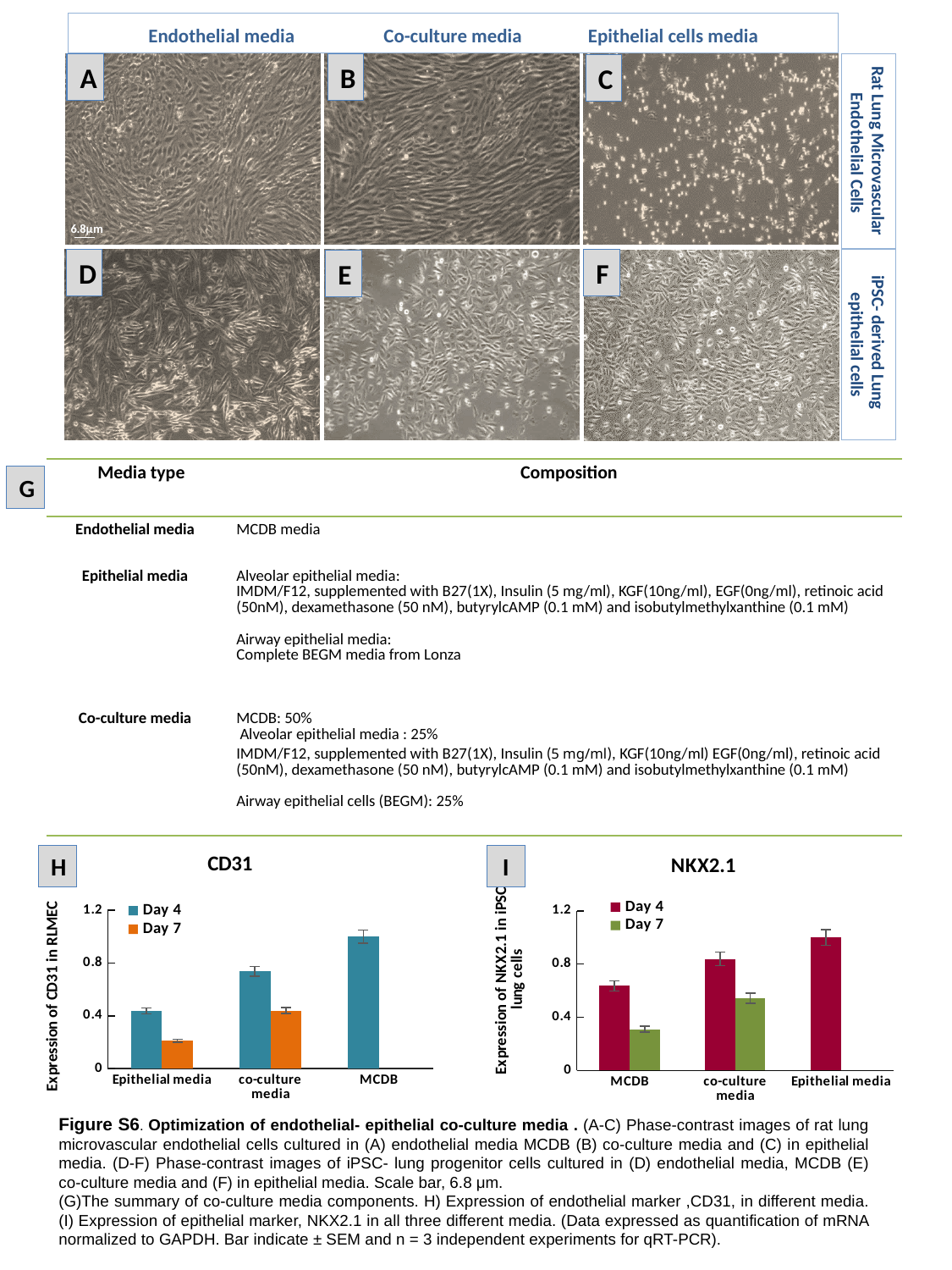
In the NKX2.1 chart, do the Day 4 values rise or fall from MCDB to Epithelial media along the x axis? rise In the CD31 chart, which is larger for Epithelial media: the Day 4 value or the Day 7 value? Day 4 In the NKX2.1 chart, which is larger: the Day 4 value for co-culture media or the Day 4 value for MCDB? co-culture media How many media categories are shown on the x axis of the CD31 chart? 3 In the NKX2.1 chart, which media has the lowest Day 4 expression? MCDB In the CD31 chart, which media has the highest Day 4 expression? MCDB In the NKX2.1 chart, is the Day 7 value for MCDB greater or less than 0.4? less How many series does the legend of the NKX2.1 chart list? 2 In the CD31 chart, is the Day 4 value for co-culture media greater or less than 0.4? greater In the NKX2.1 chart, which series is shown in green? Day 7 What kind of chart is the CD31 chart? bar chart What is the y-axis label of the CD31 chart? Expression of CD31 in RLMEC